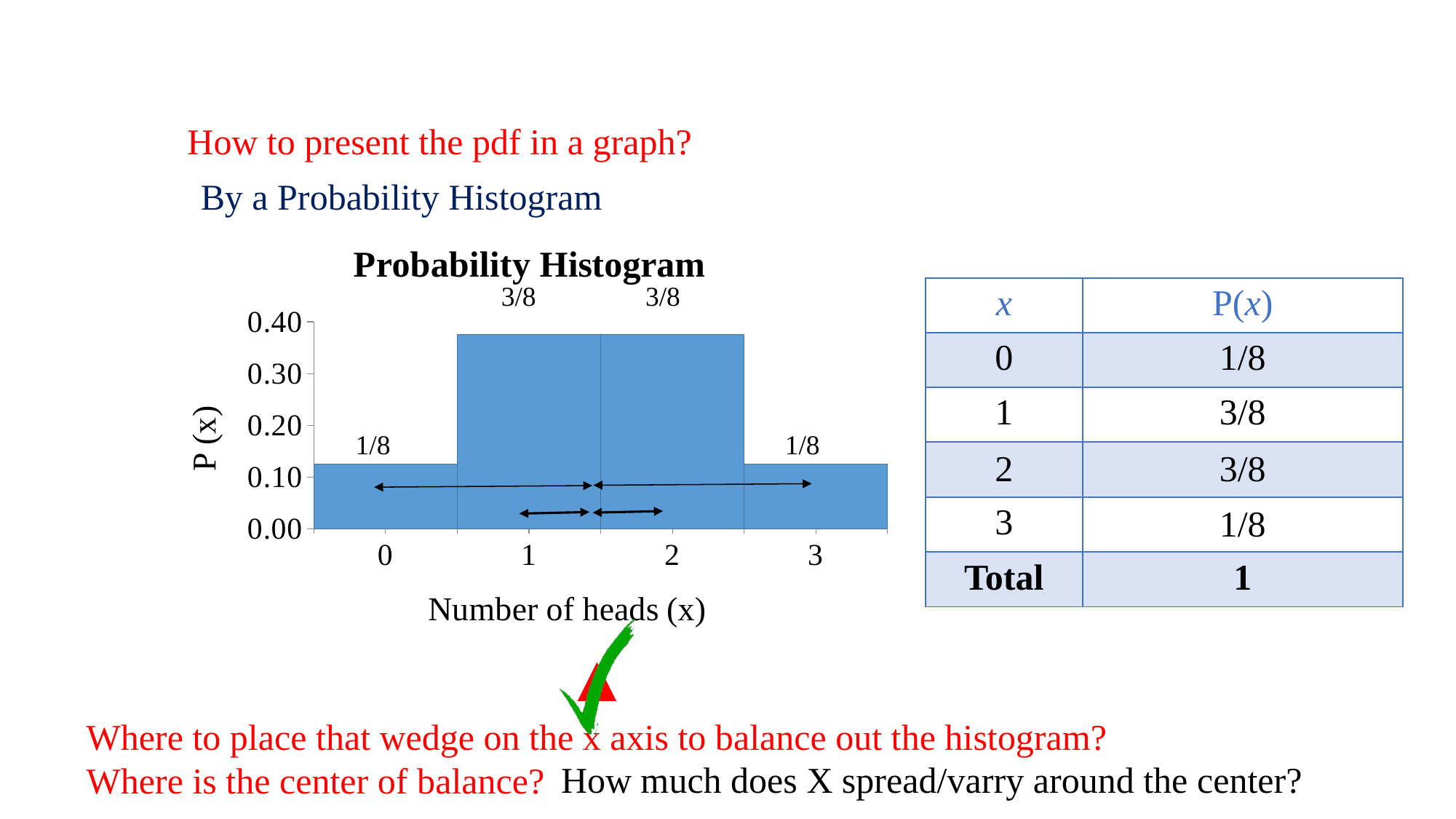
Is the value for x = 1 in the Probability Histogram greater or less than 0.30? greater What is the label of the x axis of the Probability Histogram? Number of heads (x) Which values of x have the lowest probability in the Probability Histogram? 0 and 3 What is the value of P(x) for x = 0 in the Probability Histogram? 1/8 Is the value for x = 0 in the Probability Histogram greater or less than 0.20? less What is the value of P(x) for x = 1 in the Probability Histogram? 3/8 Which values of x have the highest probability in the Probability Histogram? 1 and 2 Which is larger in the Probability Histogram: P(x) for x = 2 or P(x) for x = 3? x = 2 How many values of x are shown on the x axis of the Probability Histogram? 4 What is the value of P(x) for x = 3 in the Probability Histogram? 1/8 What is the difference between P(x) for x = 1 and P(x) for x = 0 in the Probability Histogram? 2/8 What type of chart is the Probability Histogram? bar chart